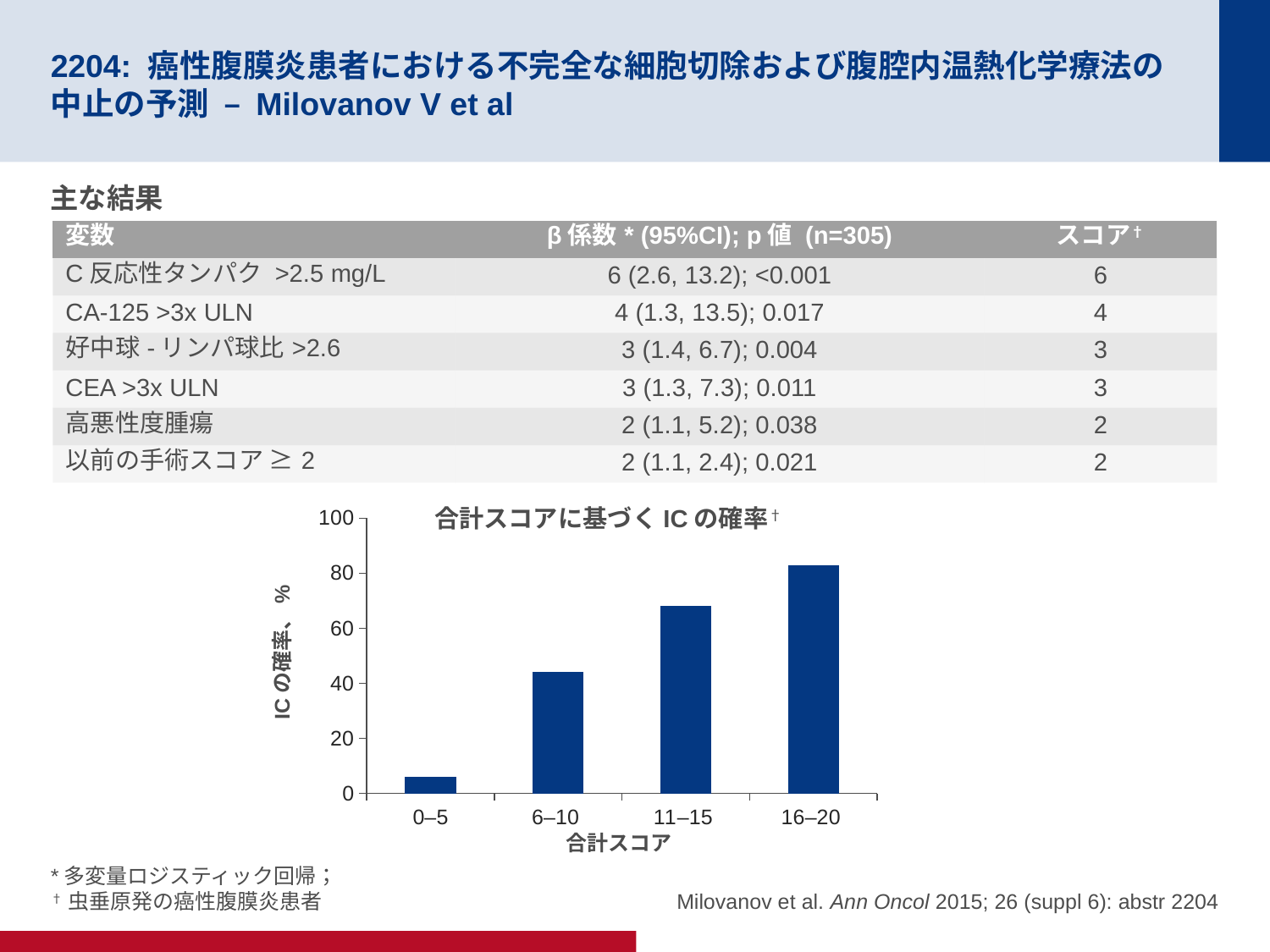
Is the value for the 6–10 score category greater or less than 40? greater Which total score category has the highest probability of IC? 16–20 Do the bar values rise or fall as the total score increases along the x axis? rise Is the value for the 0–5 score category greater or less than 20? less What kind of chart is shown on the slide? bar chart Which has a larger probability of IC, the 6–10 category or the 11–15 category? 11–15 What is the label of the x axis of the chart? 合計スコア Is the value for the 16–20 score category greater or less than 60? greater How many score categories are shown on the x axis of the chart? 4 Which total score category has the lowest probability of IC? 0–5 What is the title of the chart? 合計スコアに基づく IC の確率